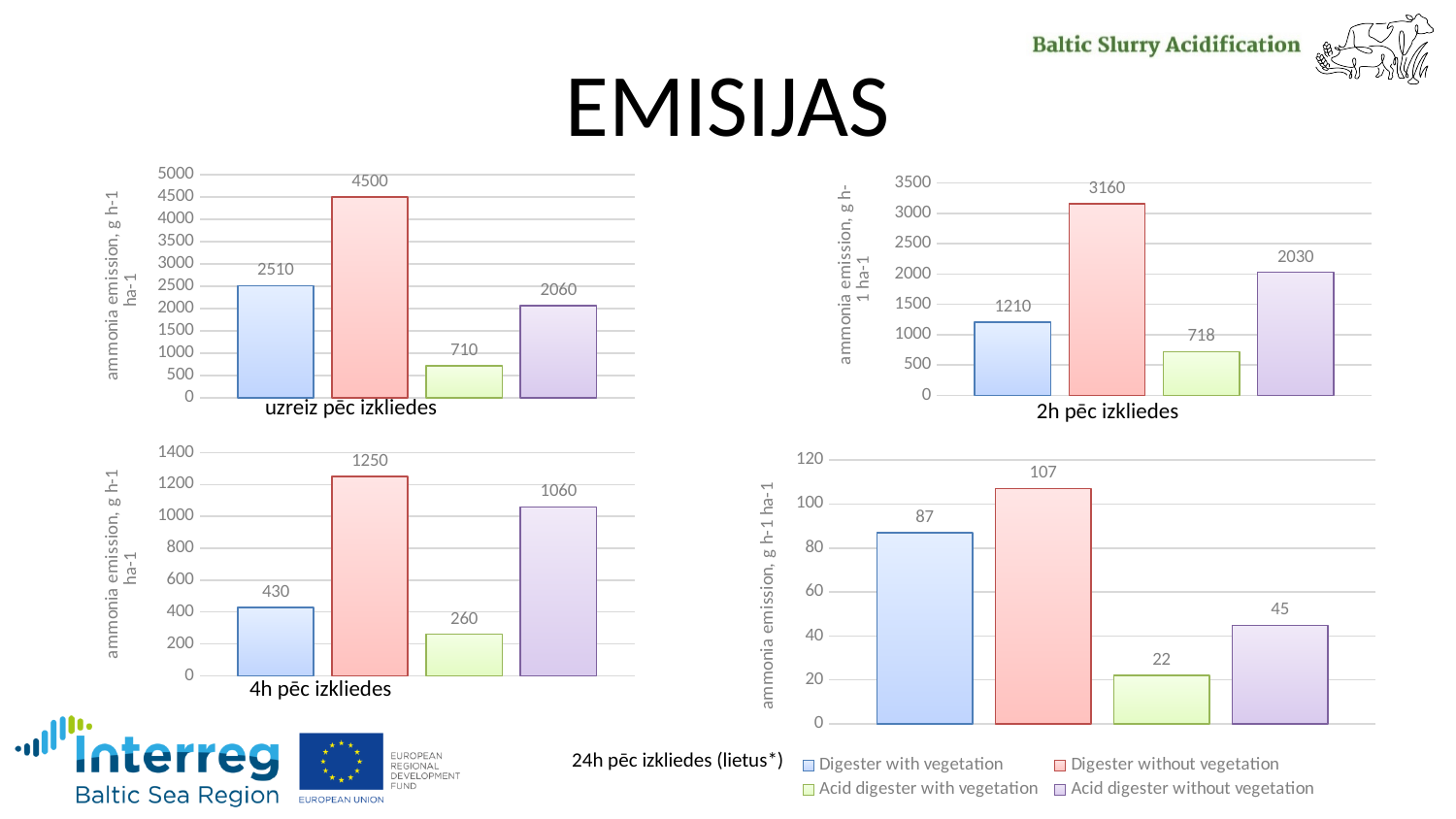
In the '2h pēc izkliedes' chart, what is the value for Acid digester with vegetation? 718 In the '2h pēc izkliedes' chart, which series has the highest ammonia emission? Digester without vegetation In the 'uzreiz pēc izkliedes' chart, which series has the lowest ammonia emission? Acid digester with vegetation In the '4h pēc izkliedes' chart, what is the difference between Digester without vegetation and Digester with vegetation? 820 In the '24h pēc izkliedes (lietus*)' chart, what is the value for Digester with vegetation? 87 In the 'uzreiz pēc izkliedes' chart, what is the ammonia emission value for Digester without vegetation? 4500 In the '2h pēc izkliedes' chart, which is larger: Digester with vegetation or Acid digester without vegetation? Acid digester without vegetation In the '24h pēc izkliedes (lietus*)' chart, what is the difference between Acid digester without vegetation and Acid digester with vegetation? 23 How many series does the legend list? 4 In the '4h pēc izkliedes' chart, what is the value for Acid digester without vegetation? 1060 How many bars are shown in the 'uzreiz pēc izkliedes' chart? 4 What kind of chart is the '24h pēc izkliedes (lietus*)' chart? Bar chart